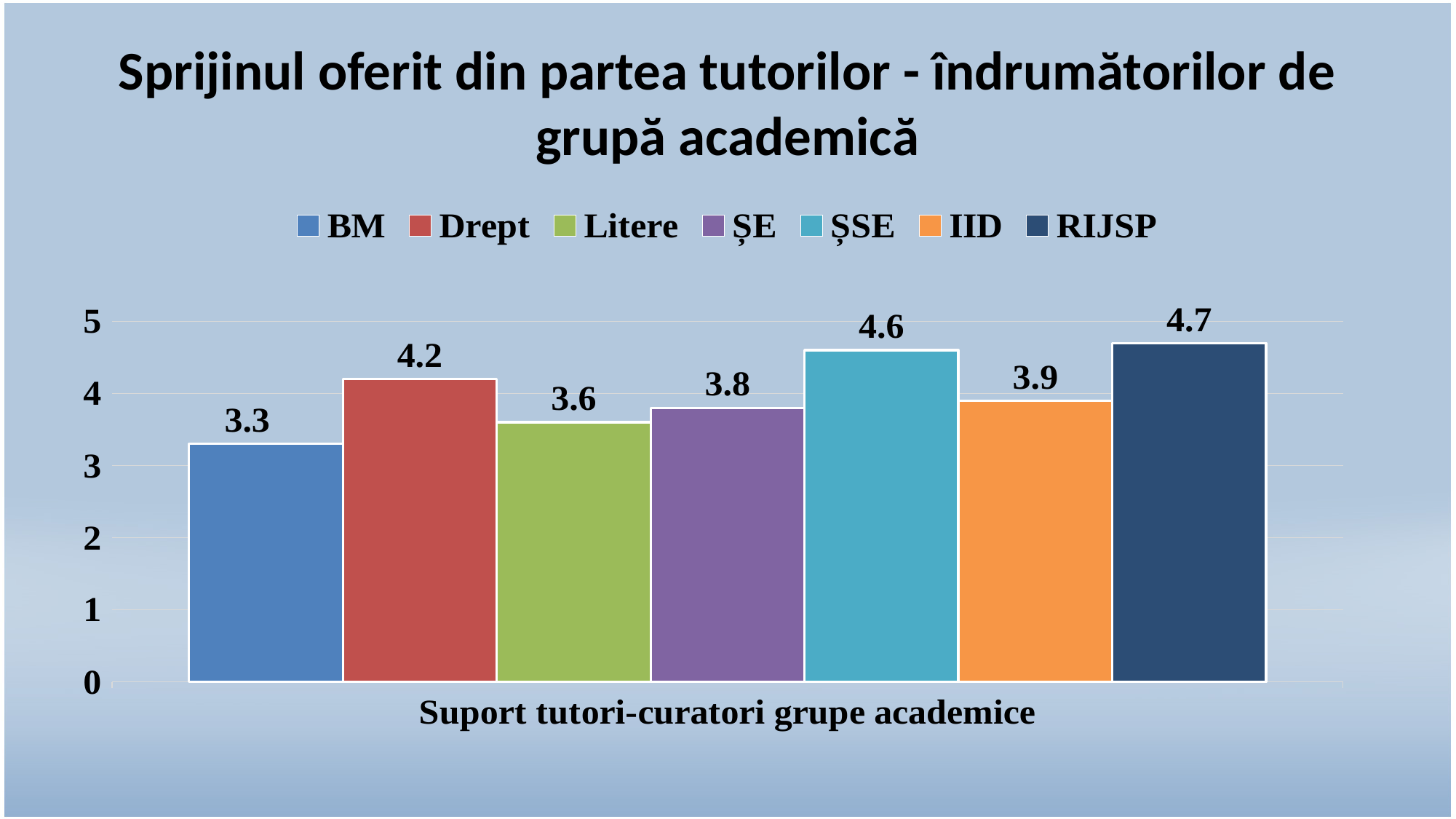
Which is larger, the value for ȘE or the value for IID? IID Is the value for Litere greater or less than 4? less What kind of chart is shown on the slide? bar chart Which series has the highest value? RIJSP What is the difference between the values for Drept and Litere? 0.6 Which series has the lowest value? BM What is the value for ȘSE? 4.6 How many series does the legend list? 7 What is the value for IID? 3.9 What is the value for Drept? 4.2 What is the label shown on the x axis of the chart? Suport tutori-curatori grupe academice What is the difference between the values for RIJSP and BM? 1.4